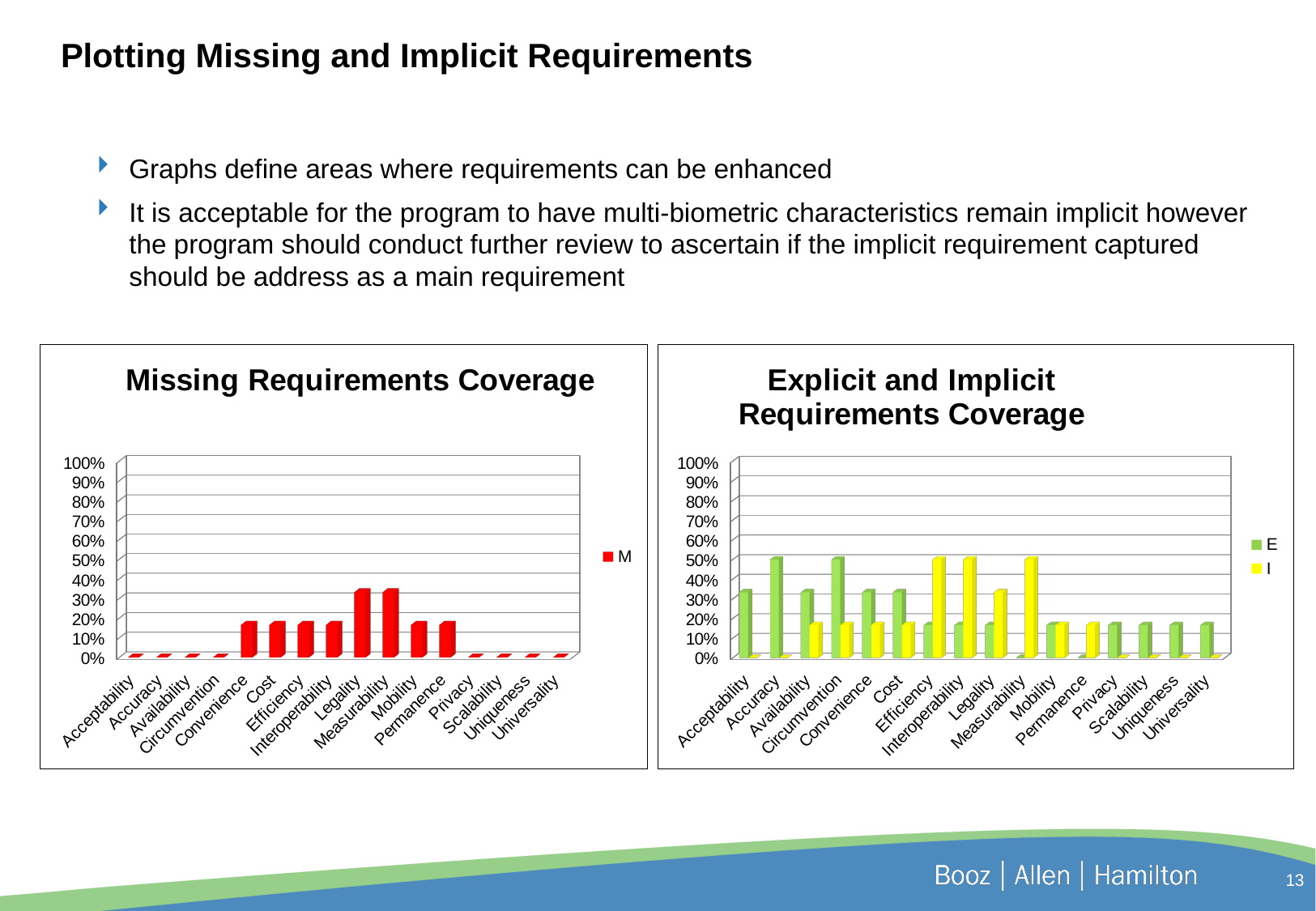
What is the title of the chart on the left of the slide? Missing Requirements Coverage What are the legend entries of the "Explicit and Implicit Requirements Coverage" chart? E and I In the "Explicit and Implicit Requirements Coverage" chart, which is larger, the E value for Accuracy or the E value for Efficiency? Accuracy How many series does the legend of the "Explicit and Implicit Requirements Coverage" chart list? 2 What kind of chart is the "Missing Requirements Coverage" chart? bar chart In the "Explicit and Implicit Requirements Coverage" chart, is the E value for Accuracy greater or less than 40%? greater How many categories are shown on the x axis of the "Missing Requirements Coverage" chart? 16 In the "Explicit and Implicit Requirements Coverage" chart, is the I value for Efficiency greater or less than 40%? greater In the "Missing Requirements Coverage" chart, is the value for Convenience greater or less than 20%? less In the "Explicit and Implicit Requirements Coverage" chart, which is larger for Efficiency, the E value or the I value? I In the "Missing Requirements Coverage" chart, which is larger, the value for Legality or the value for Cost? Legality